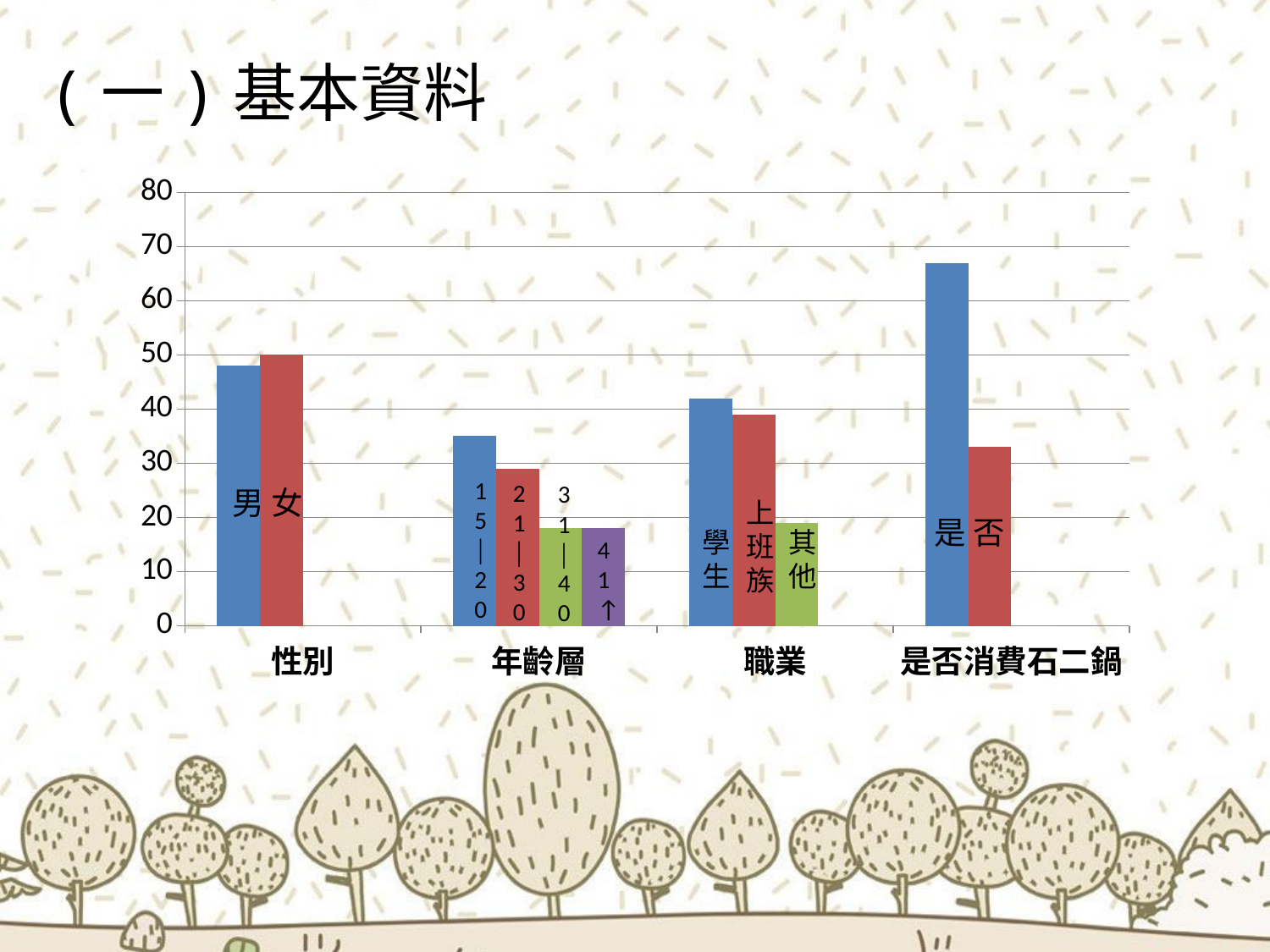
Do the bars in the 年齡層 group rise or fall from 15—20 to 41↑? fall How many category groups are shown along the x axis? 4 Within the 職業 group, which bar is the highest? 學生 Is the value for 否 greater or less than 40? less Is the value for 是 greater or less than 60? greater How many bars are in the 年齡層 group? 4 Within the 年齡層 group, which bar is the highest? 15—20 Within the 職業 group, which bar is the lowest? 其他 Which bar is the tallest in the whole chart? 是 What kind of chart is shown on the slide? bar chart Is the value for 15—20 greater or less than 30? greater Which is larger, the value for 是 or the value for 否? 是